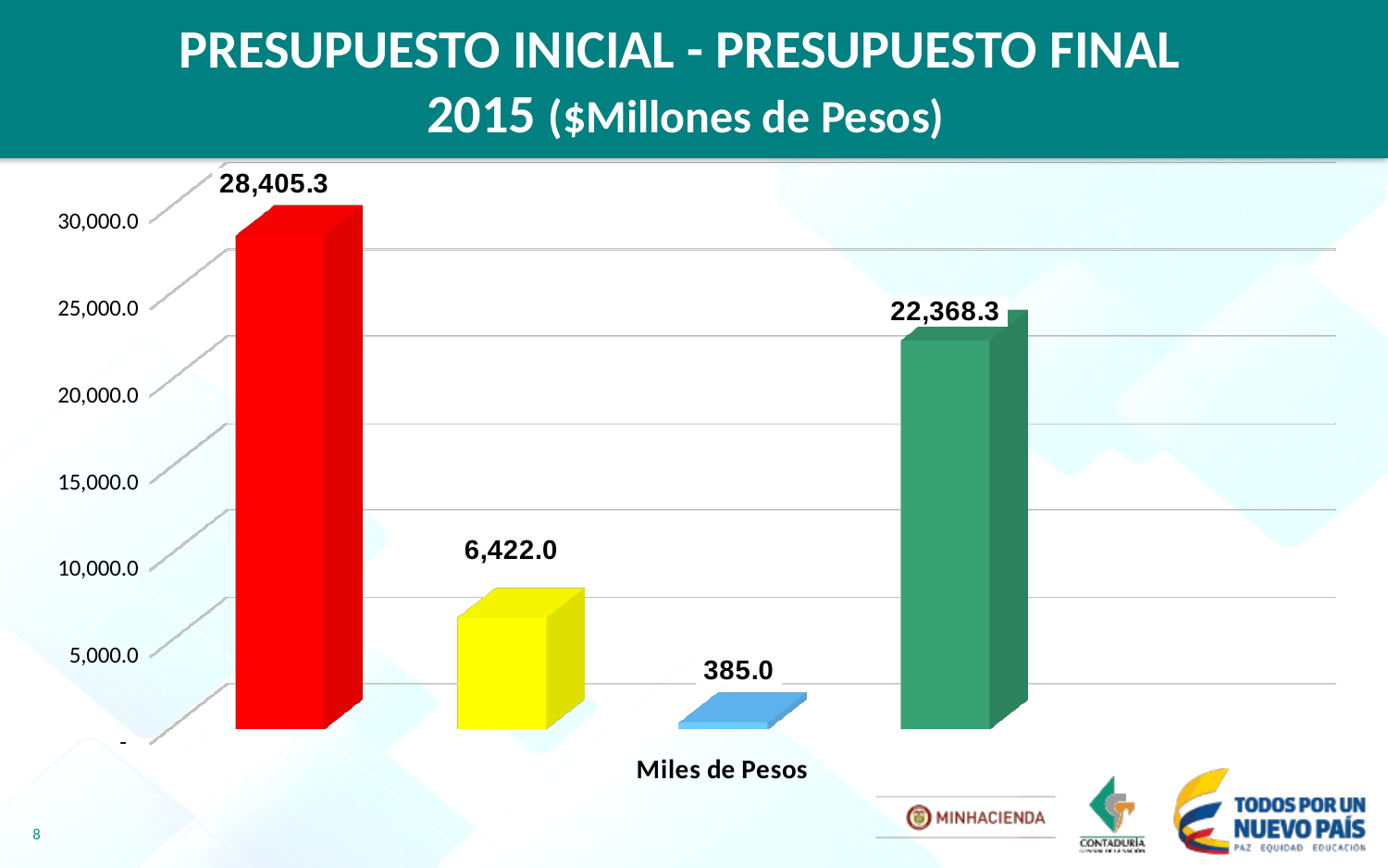
What is the difference between the red bar and the green bar? 6,037.0 What is the value shown on the green bar? 22,368.3 Which bar has the lowest value? The blue bar (385.0) Which is larger, the yellow bar or the green bar? The green bar What is the value shown on the blue bar? 385.0 What is the difference between the yellow bar and the blue bar? 6,037.0 How many bars are plotted in the chart? 4 What is the value shown on the yellow bar? 6,422.0 What type of chart is shown on the slide? Bar chart What is the title of the chart on the slide? PRESUPUESTO INICIAL - PRESUPUESTO FINAL 2015 ($Millones de Pesos) Which bar has the highest value? The red bar (28,405.3) What is the value shown on the red bar? 28,405.3